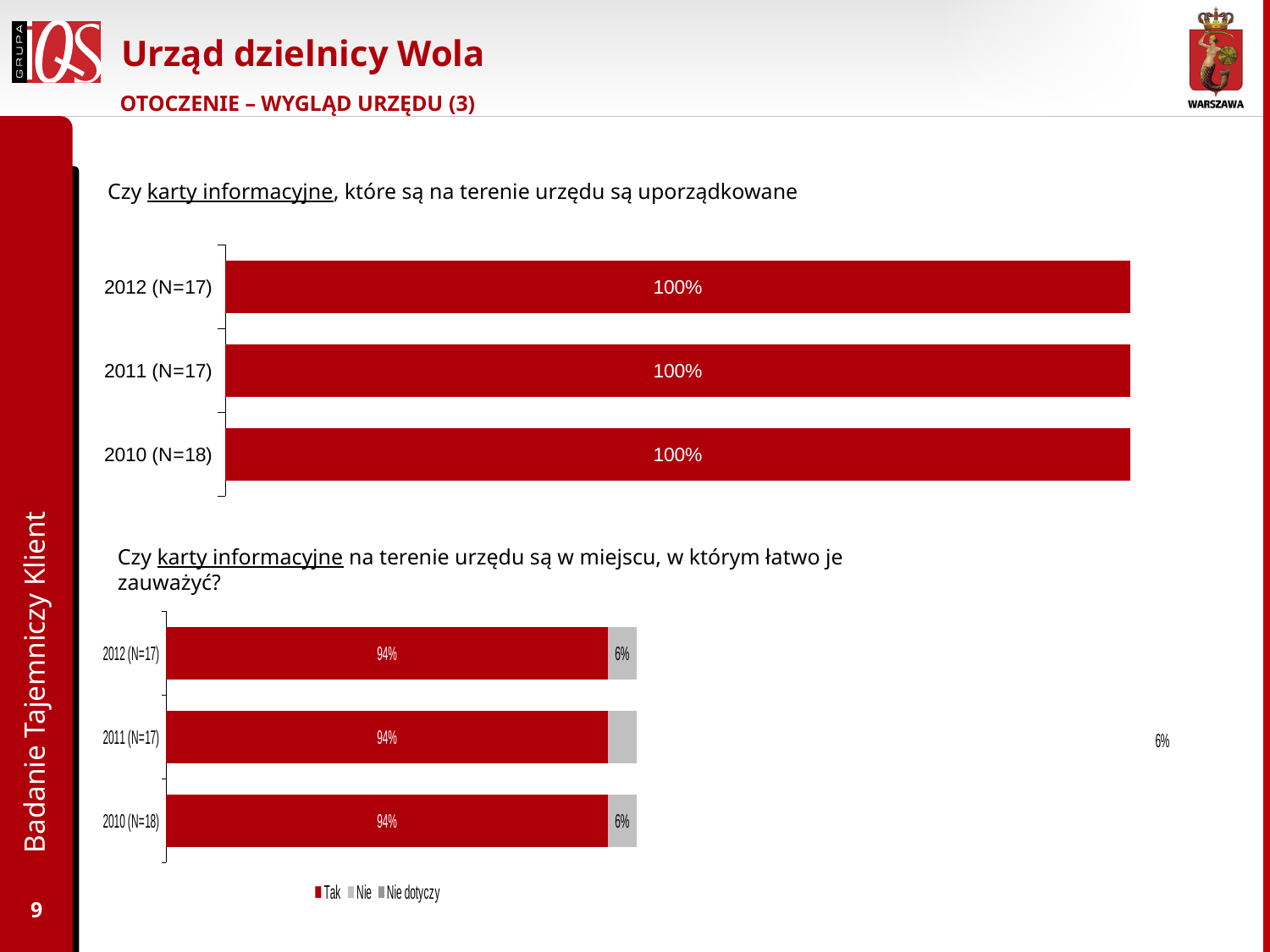
In the top chart ("Czy karty informacyjne, które są na terenie urzędu są uporządkowane"), how many categories are shown? 3 In the bottom chart ("Czy karty informacyjne na terenie urzędu są w miejscu, w którym łatwo je zauważyć?"), what is the Tak value for 2012 (N=17)? 94% In the top chart ("Czy karty informacyjne, które są na terenie urzędu są uporządkowane"), what is the value for 2012 (N=17)? 100% In the bottom chart ("Czy karty informacyjne na terenie urzędu są w miejscu, w którym łatwo je zauważyć?"), does the Tak value rise, fall or stay the same from 2010 to 2012? Stays the same In the top chart ("Czy karty informacyjne, które są na terenie urzędu są uporządkowane"), what is the value for 2010 (N=18)? 100% In the top chart ("Czy karty informacyjne, które są na terenie urzędu są uporządkowane"), what is the difference between the values for 2012 (N=17) and 2011 (N=17)? 0% What kind of chart is the top chart ("Czy karty informacyjne, które są na terenie urzędu są uporządkowane")? Bar chart In the bottom chart ("Czy karty informacyjne na terenie urzędu są w miejscu, w którym łatwo je zauważyć?"), what is the Nie value for 2010 (N=18)? 6% In the bottom chart ("Czy karty informacyjne na terenie urzędu są w miejscu, w którym łatwo je zauważyć?"), which is larger for 2012 (N=17): Tak or Nie? Tak In the bottom chart ("Czy karty informacyjne na terenie urzędu są w miejscu, w którym łatwo je zauważyć?"), what is the total of the 2010 (N=18) bar? 100% In the bottom chart ("Czy karty informacyjne na terenie urzędu są w miejscu, w którym łatwo je zauważyć?"), what are the legend entries? Tak, Nie, Nie dotyczy In the bottom chart ("Czy karty informacyjne na terenie urzędu są w miejscu, w którym łatwo je zauważyć?"), how many series does the legend list? 3